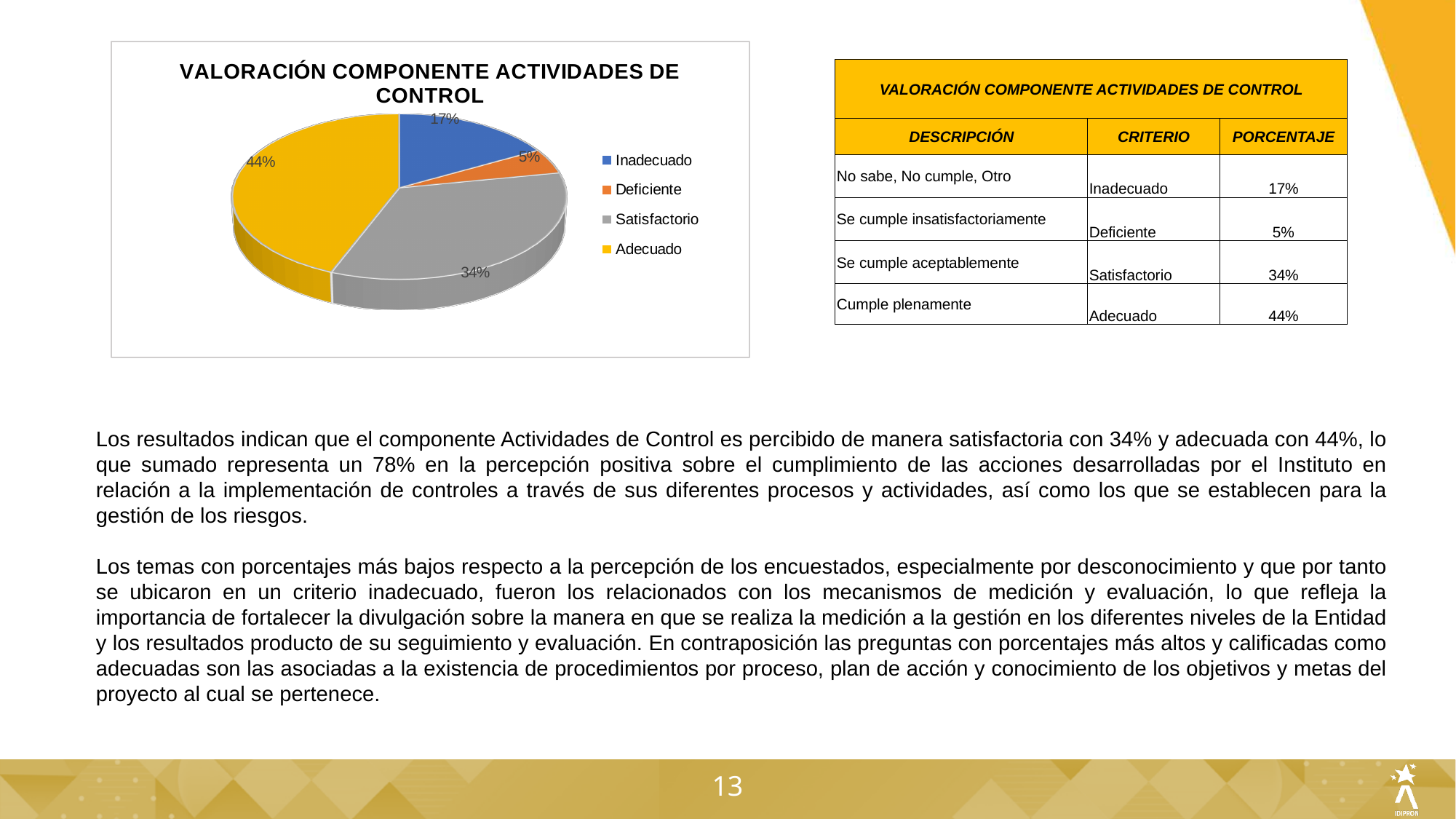
What percentage does the Inadecuado slice represent? 17% Which category has the smallest share of the pie? Deficiente How many categories does the pie chart show? 4 Which colour represents Satisfactorio in the legend? Grey What percentage does the Deficiente slice represent? 5% What is the difference in percentage points between Adecuado and Satisfactorio? 10 What percentage does the Satisfactorio slice represent? 34% Which is larger, the Inadecuado slice or the Deficiente slice? Inadecuado What type of chart is shown on the slide? Pie chart Which category has the largest share of the pie? Adecuado What percentage does the Adecuado slice represent? 44% What is the title of the chart? VALORACIÓN COMPONENTE ACTIVIDADES DE CONTROL